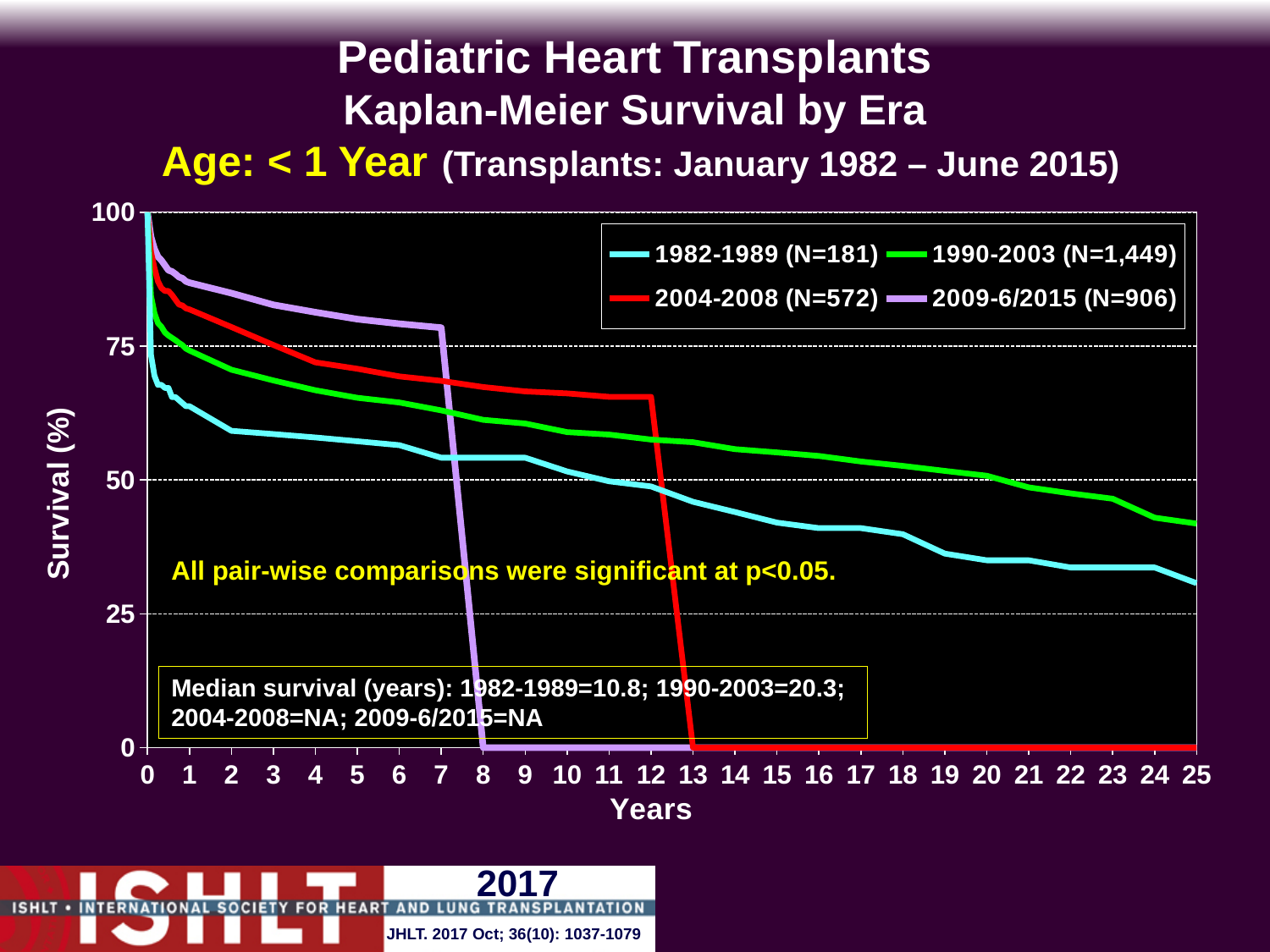
Do the survival curves rise or fall as years increase? fall Is the survival for the 2009-6/2015 era at 5 years greater or less than 75? greater What is the median survival for the 2004-2008 era? NA Which era has the lowest survival at 5 years? 1982-1989 What is the median survival in years for the 1990-2003 era? 20.3 Which era has the highest survival at 5 years? 2009-6/2015 Is the survival for the 1982-1989 era at 25 years greater or less than 50? less How many transplants (N) are in the 2004-2008 era? 572 At 10 years, which era has higher survival: 2004-2008 or 1990-2003? 2004-2008 What kind of chart is shown on the slide? line chart What is the median survival in years for the 1982-1989 era? 10.8 How many series does the legend list? 4